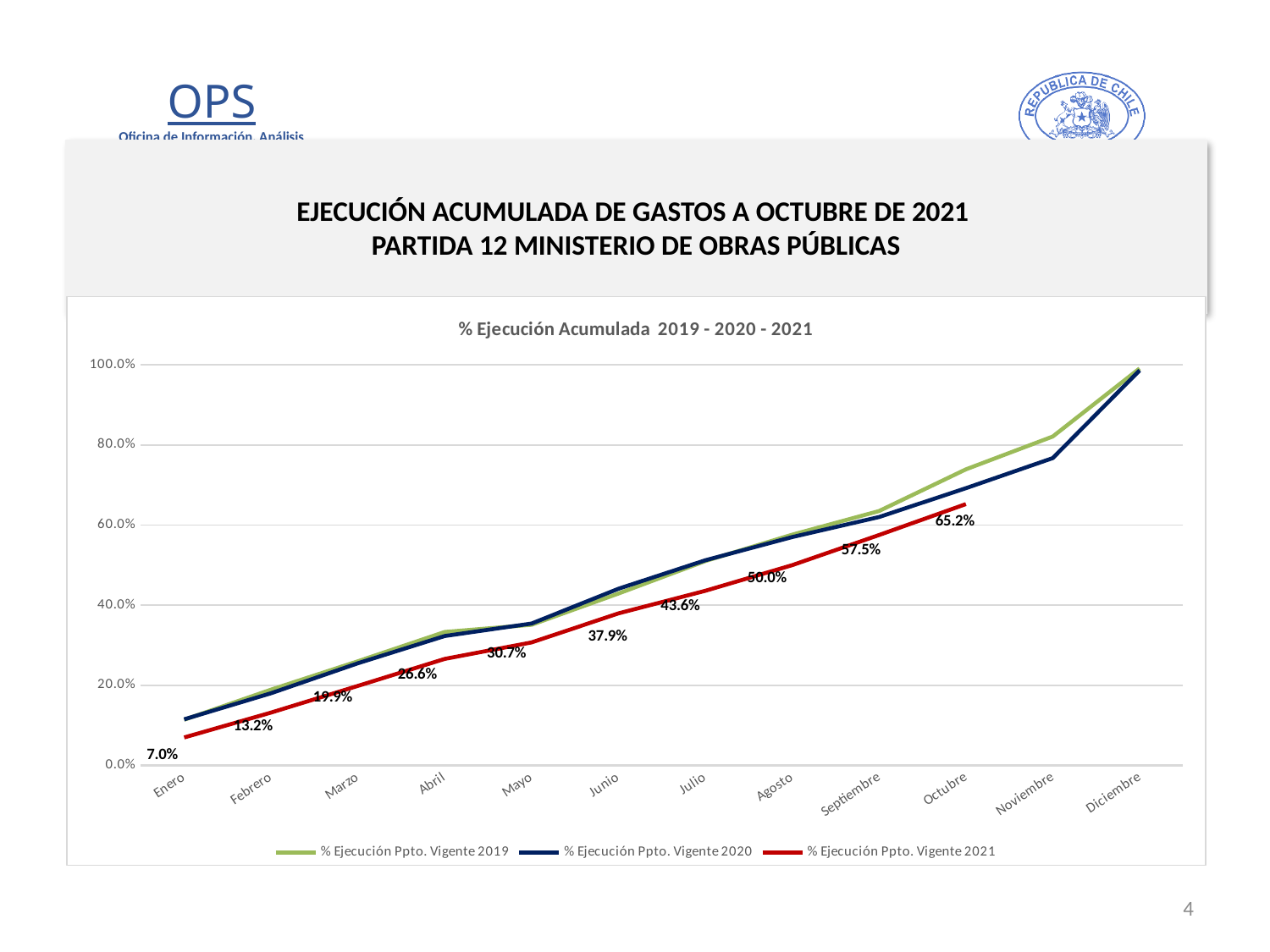
What is the value for % Ejecución Ppto. Vigente 2021 in Mayo? 30.7% Is the value for % Ejecución Ppto. Vigente 2019 in Octubre greater or less than 60.0%? greater What is the title of the chart? % Ejecución Acumulada 2019 - 2020 - 2021 How many months are shown along the x axis? 12 How many series does the legend list? 3 What kind of chart is shown on the slide? line chart What is the difference between the 2021 values for Octubre and Septiembre? 7.7% What is the value for % Ejecución Ppto. Vigente 2021 in Octubre? 65.2% Which month has the lowest labelled value for % Ejecución Ppto. Vigente 2021? Enero What is the value for % Ejecución Ppto. Vigente 2021 in Enero? 7.0% Which month has the highest labelled value for % Ejecución Ppto. Vigente 2021? Octubre Do the values for % Ejecución Ppto. Vigente 2021 rise or fall from Enero to Octubre? rise